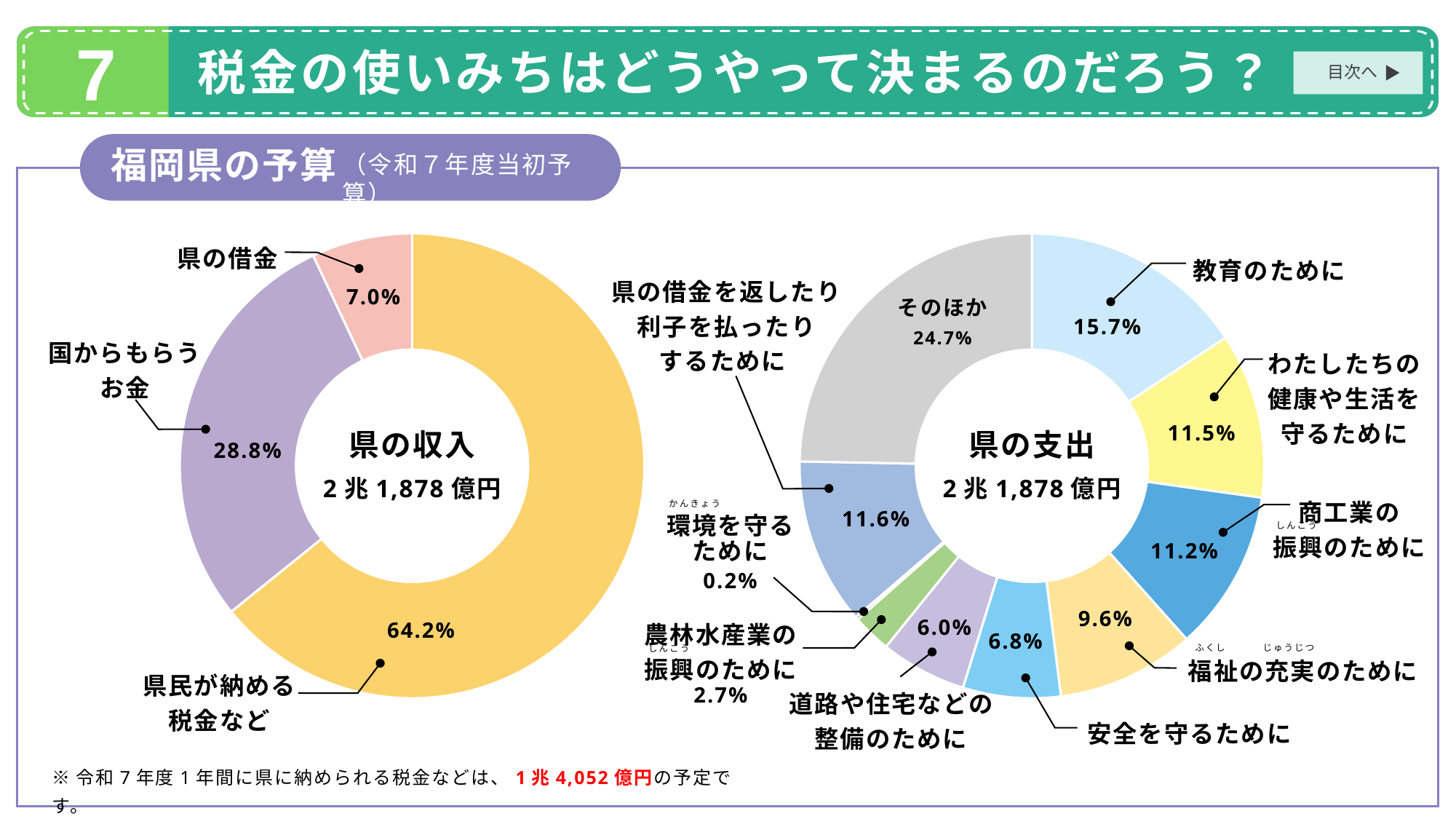
How many categories does the 県の収入 chart show? 3 In the 県の支出 chart, what share is 福祉の充実のために? 9.6% In the 県の支出 chart, which category has the smallest share? 環境を守るために In the 県の収入 chart, which category has the smallest share? 県の借金 What kind of chart is the 県の支出 chart? Pie (donut) chart In the 県の収入 chart, what share is 県民が納める税金など? 64.2% In the 県の収入 chart, what share is 国からもらうお金? 28.8% How many categories does the 県の支出 chart show? 10 In the 県の支出 chart, what share is 教育のために? 15.7% In the 県の支出 chart, which is larger: 安全を守るために or 道路や住宅などの整備のために? 安全を守るために In the 県の支出 chart, which category has the largest share? そのほか In the 県の収入 chart, what is the difference between 国からもらうお金 and 県の借金? 21.8%